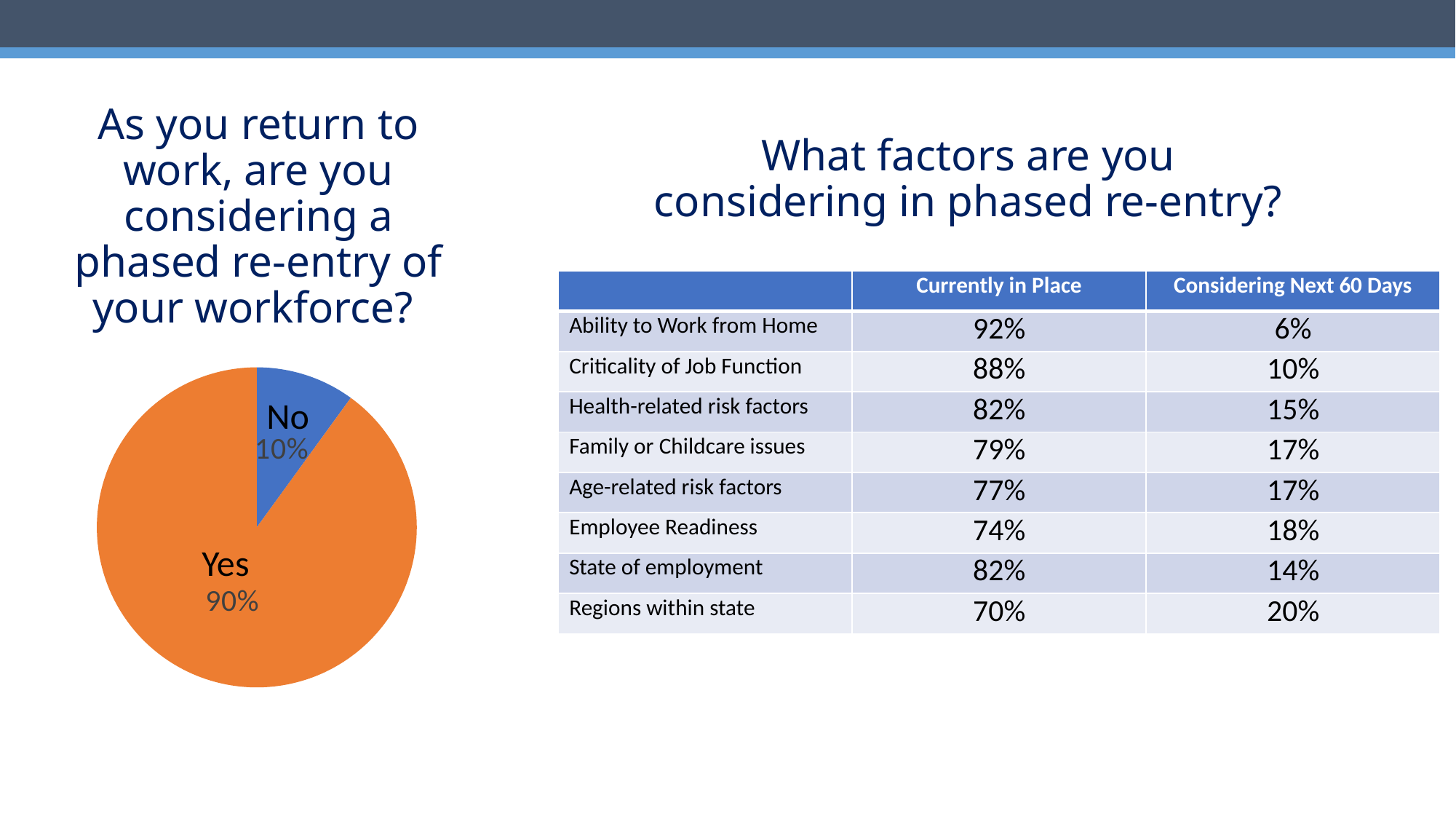
In the pie chart, which is larger, the Yes slice or the No slice? Yes What colour is the No slice in the pie chart? blue What colour is the Yes slice in the pie chart? orange Which slice of the pie chart is the largest? Yes In the pie chart, what percentage of respondents answered Yes? 90% What share of the pie chart does the No slice represent? 10% In the pie chart, what percentage of respondents answered No? 10% What kind of chart is shown on the left of the slide? pie chart How many slices does the pie chart have? 2 In the pie chart, what is the difference in percentage points between the Yes and No slices? 80% Which slice of the pie chart is the smallest? No